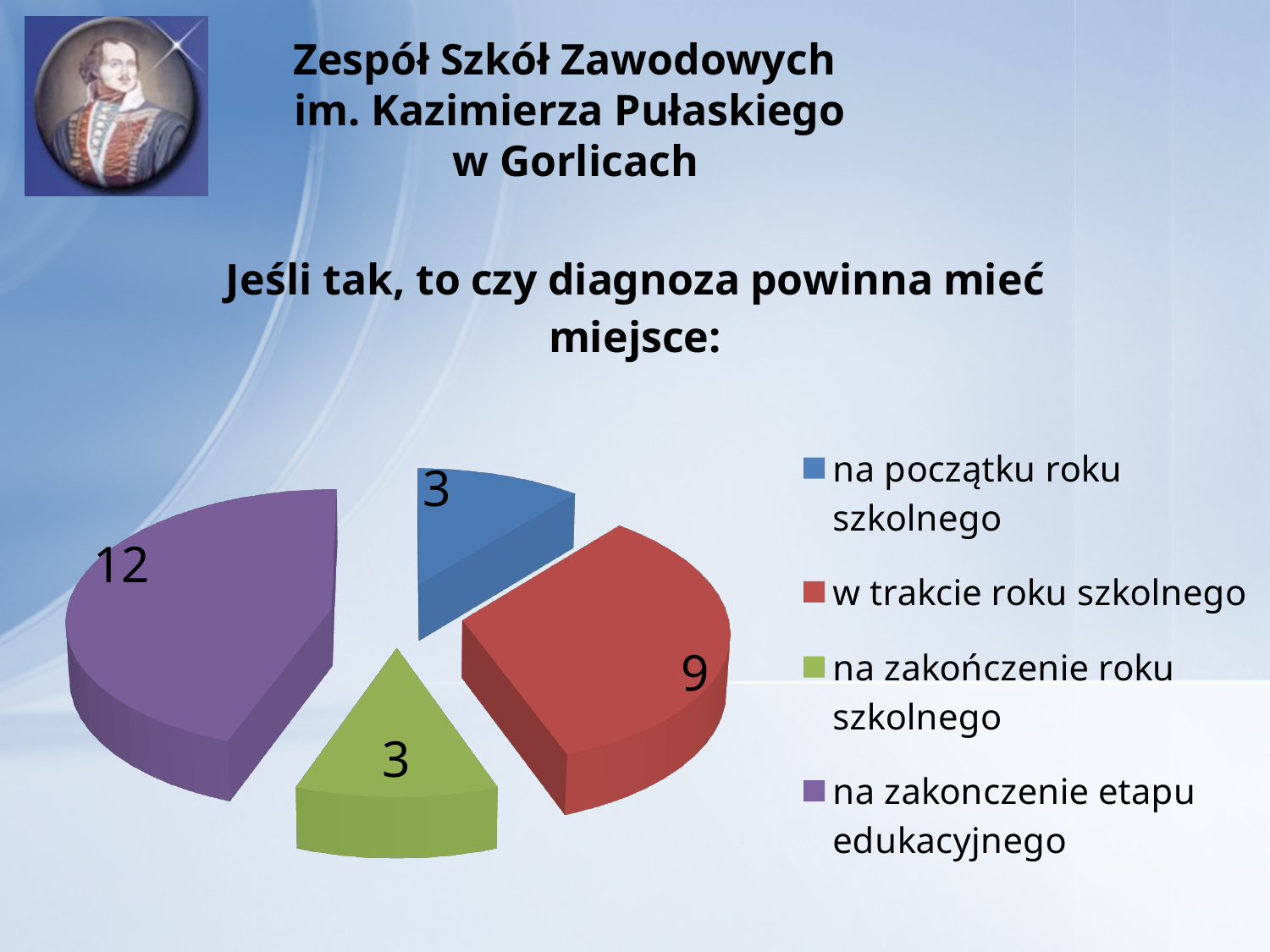
How many entries does the legend of the pie chart list? 4 Which category has the largest slice in the pie chart? na zakonczenie etapu edukacyjnego What is the difference between the values for 'na zakonczenie etapu edukacyjnego' and 'w trakcie roku szkolnego'? 3 What is the total of all the values shown in the pie chart? 27 What kind of chart is shown on the slide? pie chart What is the value for 'na zakonczenie etapu edukacyjnego'? 12 What colour is the slice for 'w trakcie roku szkolnego'? red What is the value for 'na początku roku szkolnego'? 3 What is the value for 'na zakończenie roku szkolnego'? 3 What is the value for 'w trakcie roku szkolnego'? 9 Which is larger, the value for 'w trakcie roku szkolnego' or the value for 'na początku roku szkolnego'? w trakcie roku szkolnego How many slices does the pie chart have? 4